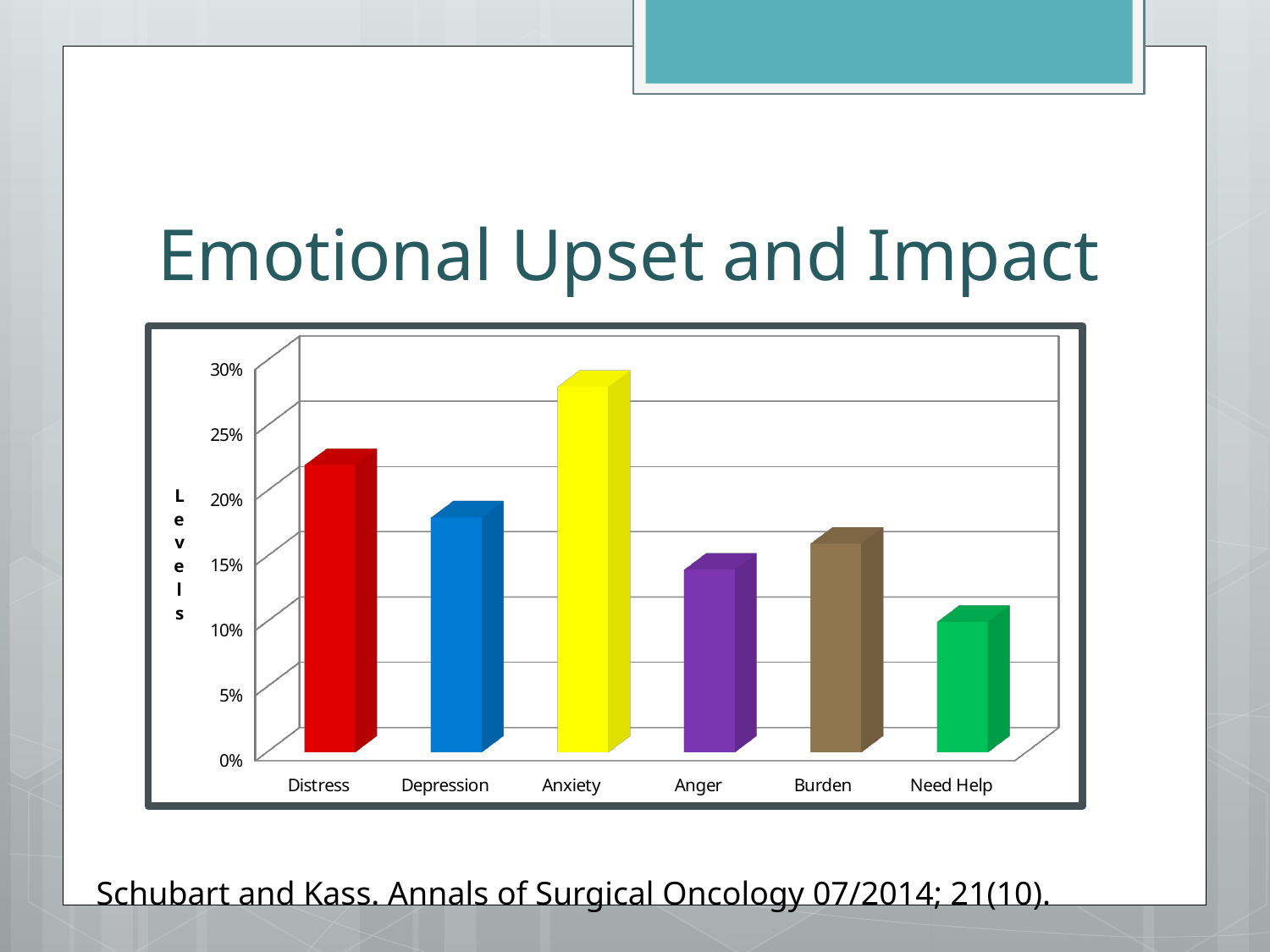
Is the value for Need Help greater or less than 15%? less Is the value for Distress greater or less than 20%? greater Which is larger, the value for Distress or the value for Depression? Distress How many categories are plotted on the chart? 6 Is the value for Depression greater or less than 15%? greater What kind of chart is shown on the slide? bar chart Which category has the lowest value? Need Help Which category has the highest value? Anxiety Which is larger, the value for Burden or the value for Anger? Burden What is the label on the vertical axis of the chart? Levels